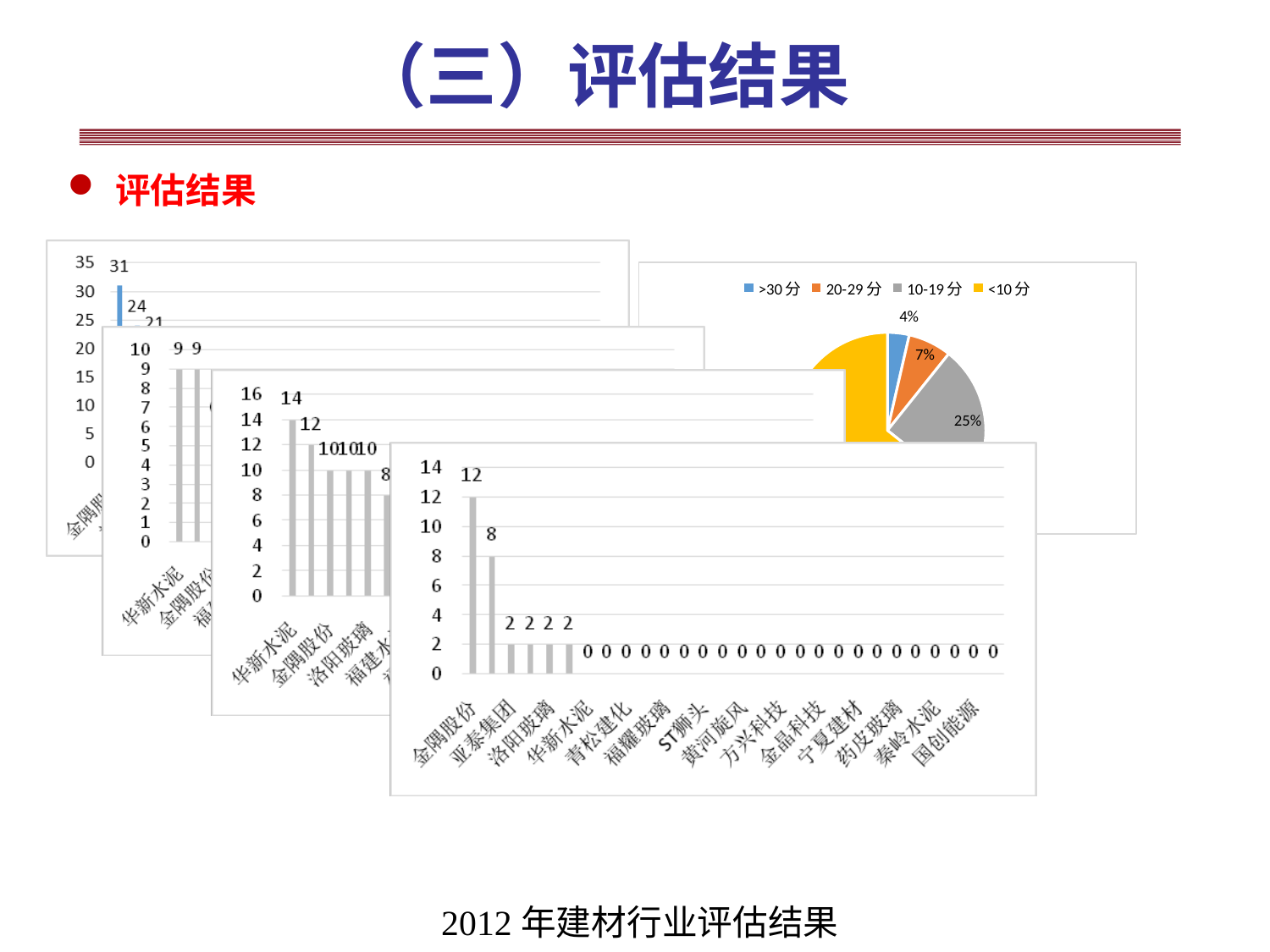
In the pie chart, what share is labelled for the >30分 slice? 4% In the front-most bar chart at the bottom right, do the values rise or fall from left to right? fall In the front-most bar chart at the bottom right, what is the second-highest value shown? 8 In the bar chart at the back top left, what is the highest value shown? 31 In the front-most bar chart at the bottom right, what is the value for 金隅股份? 12 How many entries does the legend of the pie chart list? 4 In the front-most bar chart at the bottom right, what is the highest value shown? 12 In the front-most bar chart at the bottom right, which category has the highest value? 金隅股份 In the front-most bar chart at the bottom right, what is the difference between the two highest values, 12 and 8? 4 In the pie chart, which is larger, the 20-29分 slice or the >30分 slice? 20-29分 In the pie chart, what share is labelled for the 10-19分 slice? 25% What kind of chart is the front-most chart at the bottom right? bar chart